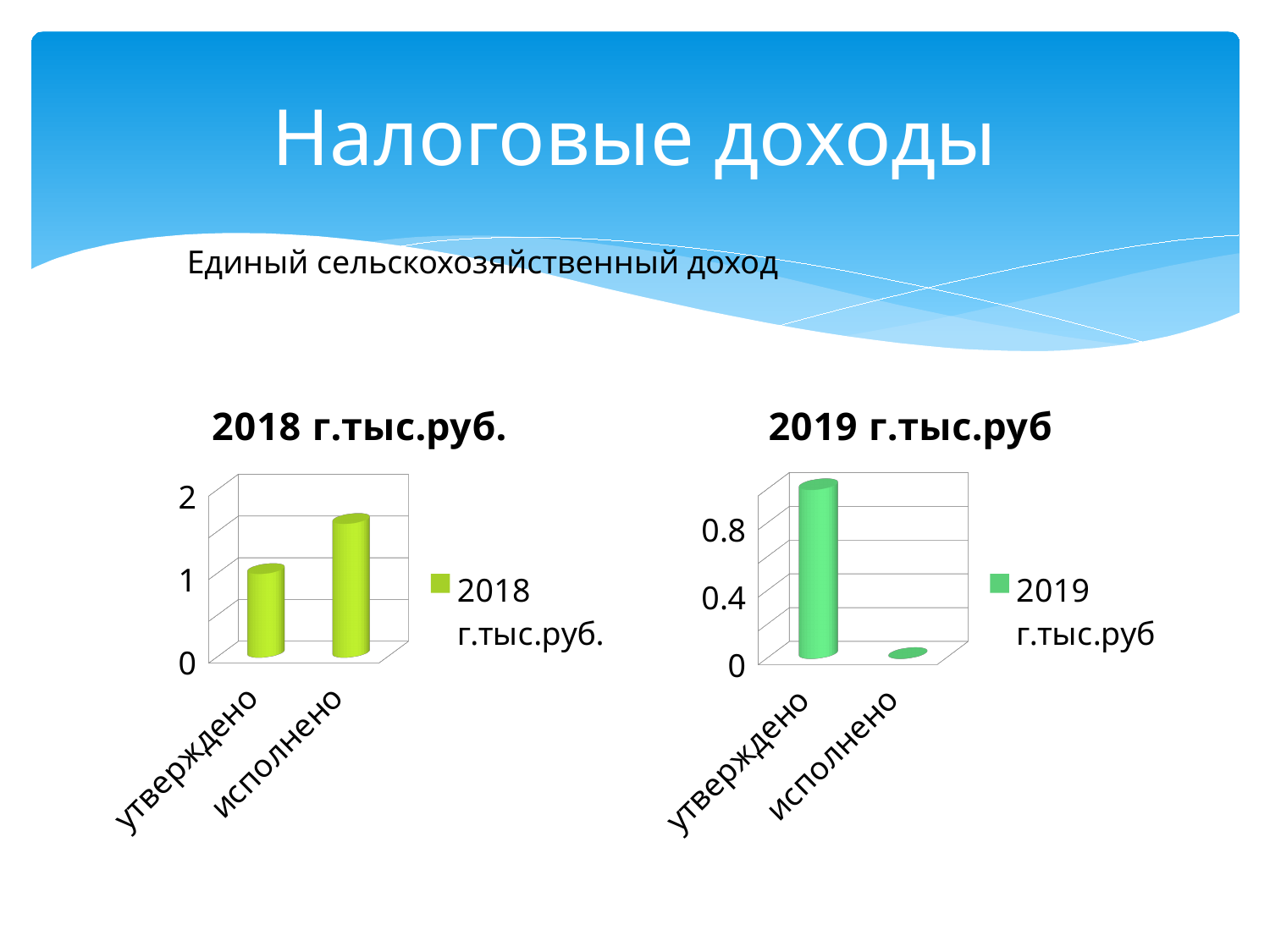
In the chart titled "2018 г.тыс.руб.", which is larger, утверждено or исполнено? исполнено In the chart titled "2019 г.тыс.руб", which category has the lowest value? исполнено How many series does the legend of the chart titled "2018 г.тыс.руб." list? 1 In the chart titled "2019 г.тыс.руб", which is larger, утверждено or исполнено? утверждено In the chart titled "2018 г.тыс.руб.", which category has the highest value? исполнено In the chart titled "2018 г.тыс.руб.", is the value for исполнено greater or less than 2? less In the chart titled "2019 г.тыс.руб", is the value for утверждено greater or less than 0.8? greater In the chart titled "2018 г.тыс.руб.", is the value for исполнено greater or less than 1? greater What kind of chart is the chart titled "2018 г.тыс.руб."? bar chart How many categories are shown on the x axis of the chart titled "2019 г.тыс.руб"? 2 What is the legend entry of the chart on the right side of the slide? 2019 г.тыс.руб